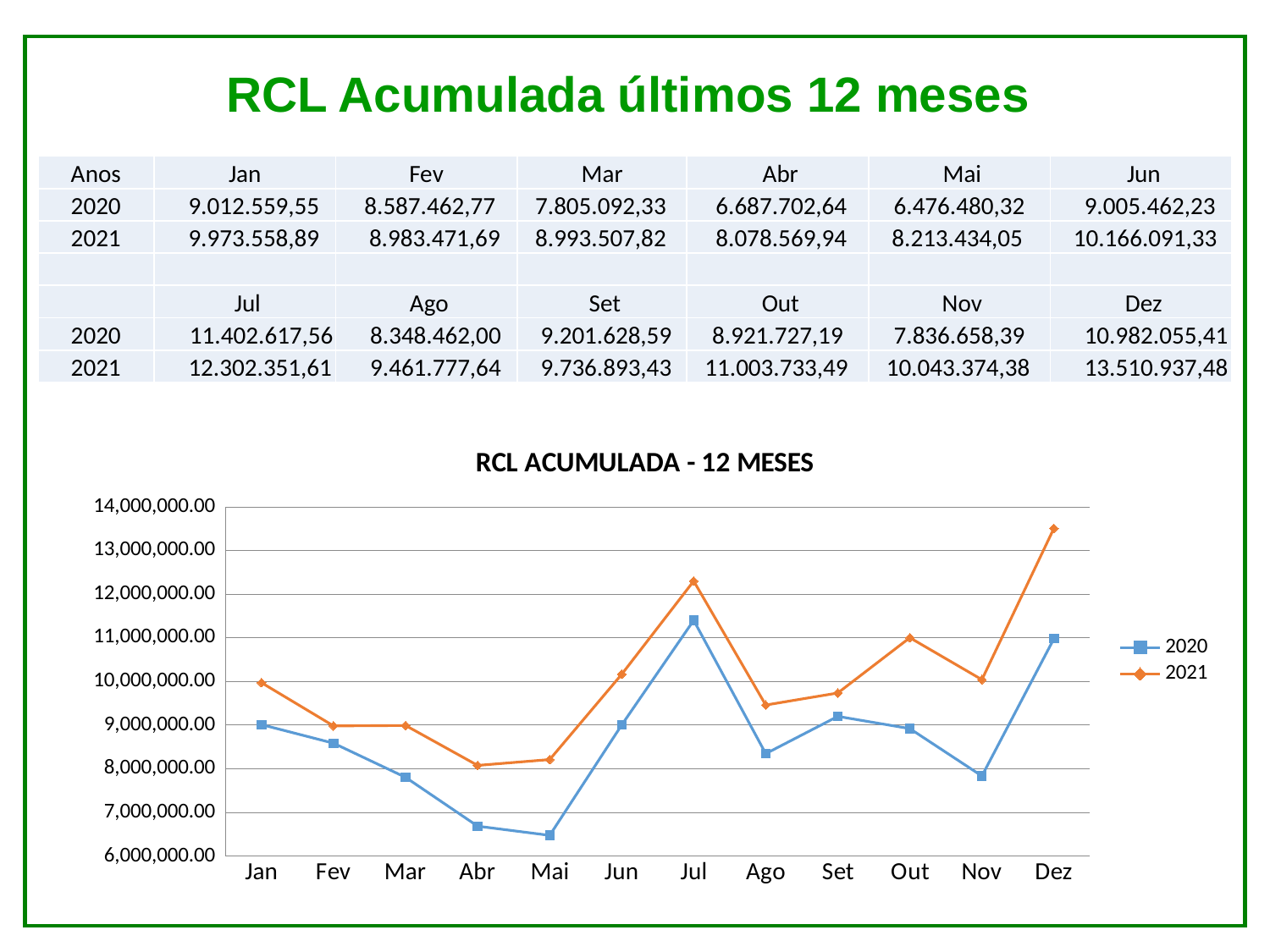
What is the value for 2021 in Dez? 13.510.937,48 How many months are plotted along the x axis of the chart? 12 Which series has the larger value in Jul, 2020 or 2021? 2021 What is the value for 2020 in Mai? 6.476.480,32 In which month does the 2020 series reach its lowest value? Mai In which month does the 2021 series reach its highest value? Dez What is the difference between the 2021 and 2020 values in Dez? 2.528.882,07 What is the title of the chart? RCL ACUMULADA - 12 MESES In which month does the 2020 series reach its highest value? Jul Is the value for 2020 in Mai greater or less than 7,000,000.00? less What kind of chart is shown on the slide? line chart How many series does the legend of the chart list? 2